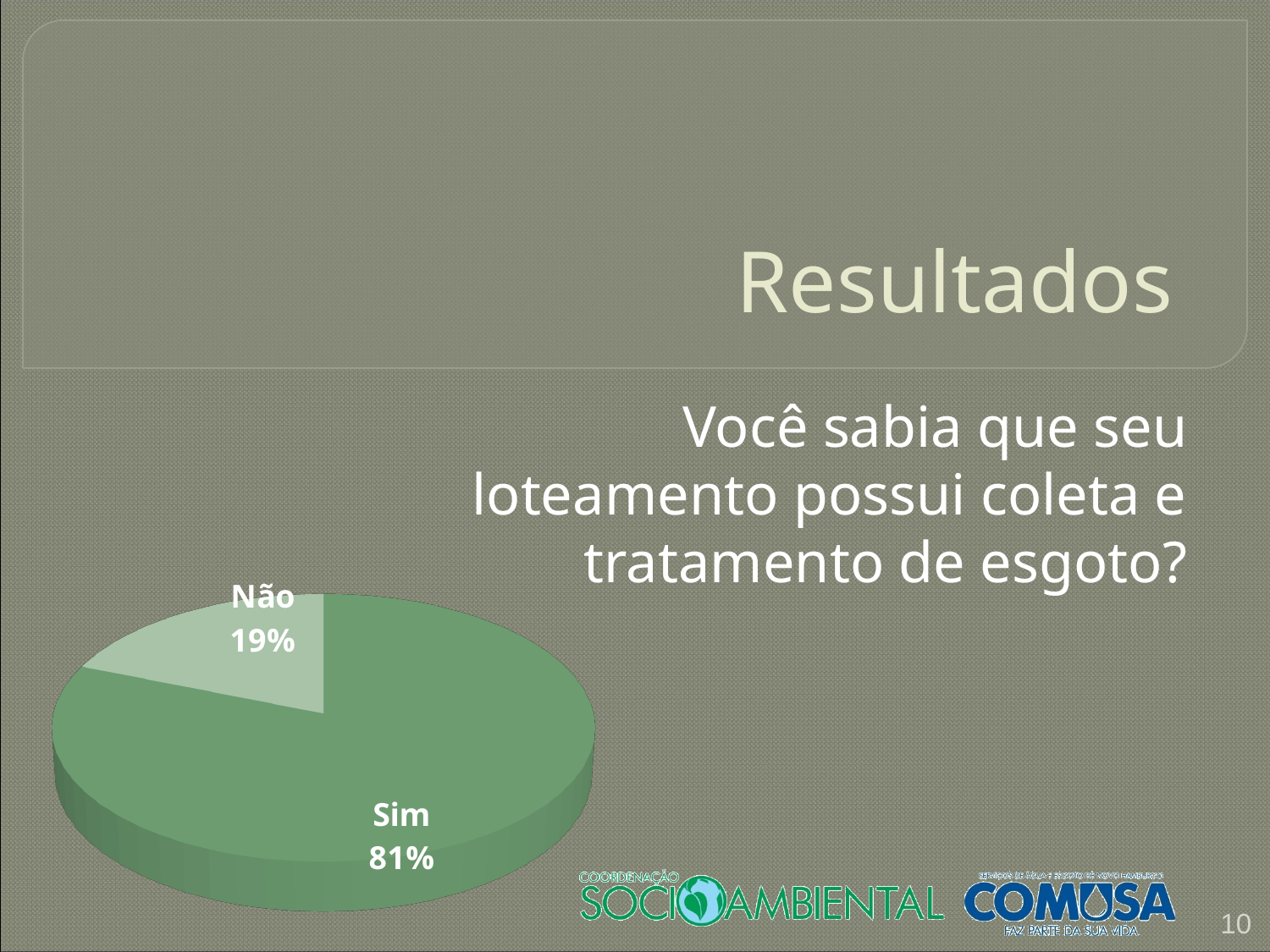
What percentage of respondents answered "Sim"? 81% What kind of chart is shown on the slide? pie chart What share of the pie does the "Não" slice represent? 19% Which slice is shown in the lighter green colour? Não Which is larger, the "Sim" slice or the "Não" slice? Sim What percentage of respondents answered "Não"? 19% Which slice of the pie chart is the largest? Sim How many slices does the pie chart have? 2 What is the difference in percentage points between the "Sim" and "Não" slices? 62 What question does the pie chart present results for? Você sabia que seu loteamento possui coleta e tratamento de esgoto? Which slice of the pie chart is the smallest? Não